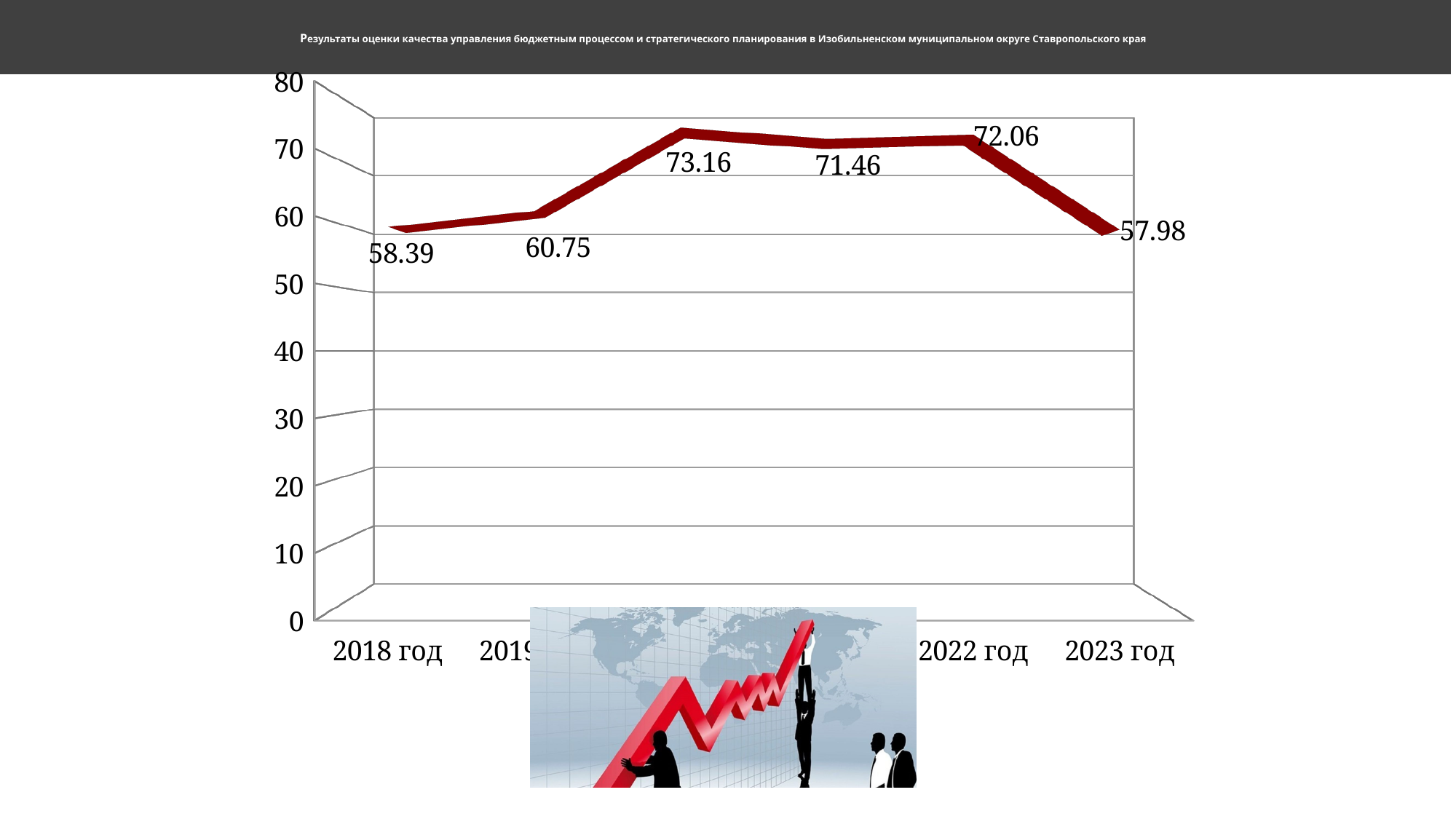
What kind of chart is shown on the slide? line chart Which is larger, the value for 2018 год or the value for 2023 год? 2018 год What is the highest value plotted on the chart? 73.16 What is the difference between the values for 2019 and 2018 год? 2.36 How many data points are plotted on the chart? 6 What is the value for 2018 год? 58.39 What is the difference between the values for 2022 год and 2023 год? 14.08 What is the value for 2022 год? 72.06 What is the value for 2023 год? 57.98 Which year has the lowest value on the chart? 2023 год Is the value for 2022 год greater or less than 70? greater What is the value for 2019? 60.75